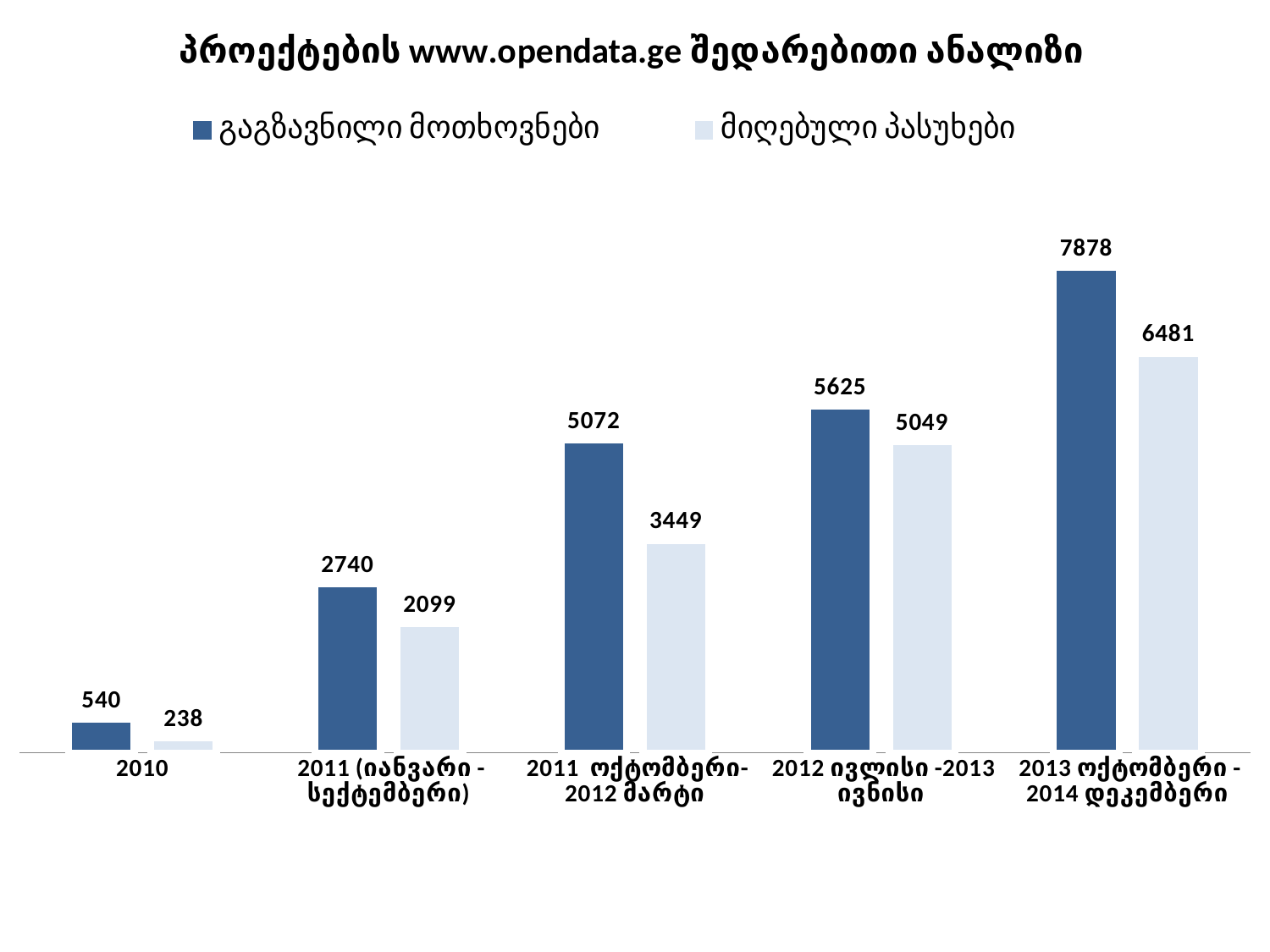
How many periods are shown on the x axis? 5 Which period has the lowest value of მიღებული პასუხები? 2010 What is the value of მიღებული პასუხები for 2011 (იანვარი - სექტემბერი)? 2099 What is the value of გაგზავნილი მოთხოვნები for 2011 ოქტომბერი - 2012 მარტი? 5072 What is the value of გაგზავნილი მოთხოვნები for 2010? 540 Which period has the highest value of გაგზავნილი მოთხოვნები? 2013 ოქტომბერი - 2014 დეკემბერი Do the values of გაგზავნილი მოთხოვნები rise or fall from 2010 to 2013 ოქტომბერი - 2014 დეკემბერი? Rise What kind of chart is shown on the slide? Bar chart What is the value of მიღებული პასუხები for 2013 ოქტომბერი - 2014 დეკემბერი? 6481 Which is larger for 2011 ოქტომბერი - 2012 მარტი: გაგზავნილი მოთხოვნები or მიღებული პასუხები? გაგზავნილი მოთხოვნები How many series does the legend list? 2 What is the difference between გაგზავნილი მოთხოვნები and მიღებული პასუხები for 2012 ივლისი - 2013 ივნისი? 576